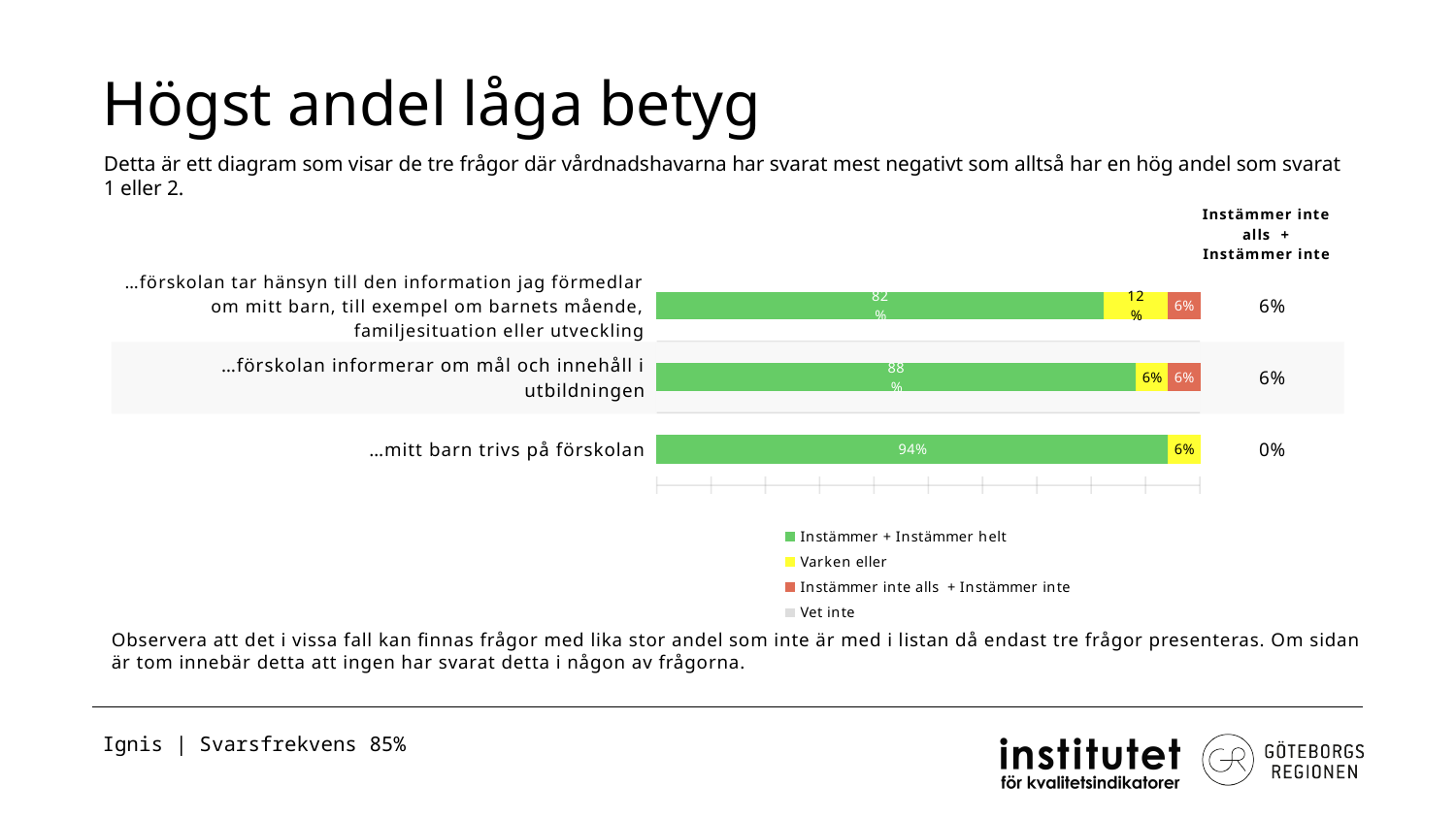
What kind of chart is shown on the slide? Stacked bar chart What is the value of "Instämmer + Instämmer helt" for "…mitt barn trivs på förskolan"? 94% Which colour represents "Instämmer inte alls + Instämmer inte" in the chart? Red How many series does the legend list? 4 How many categories (questions) are plotted in the chart? 3 What is the value of "Varken eller" for "…förskolan tar hänsyn till den information jag förmedlar om mitt barn, till exempel om barnets mående, familjesituation eller utveckling"? 12% Which category has the lowest value for "Instämmer + Instämmer helt"? …förskolan tar hänsyn till den information jag förmedlar om mitt barn, till exempel om barnets mående, familjesituation eller utveckling Which is larger: the "Varken eller" value for "…förskolan tar hänsyn till den information jag förmedlar…" or for "…förskolan informerar om mål och innehåll i utbildningen"? …förskolan tar hänsyn till den information jag förmedlar… Which category has the highest value for "Instämmer + Instämmer helt"? …mitt barn trivs på förskolan What is the value of "Instämmer + Instämmer helt" for "…förskolan informerar om mål och innehåll i utbildningen"? 88% What is the difference in "Instämmer + Instämmer helt" between "…mitt barn trivs på förskolan" and "…förskolan informerar om mål och innehåll i utbildningen"? 6% What value is shown in the "Instämmer inte alls + Instämmer inte" column for "…mitt barn trivs på förskolan"? 0%